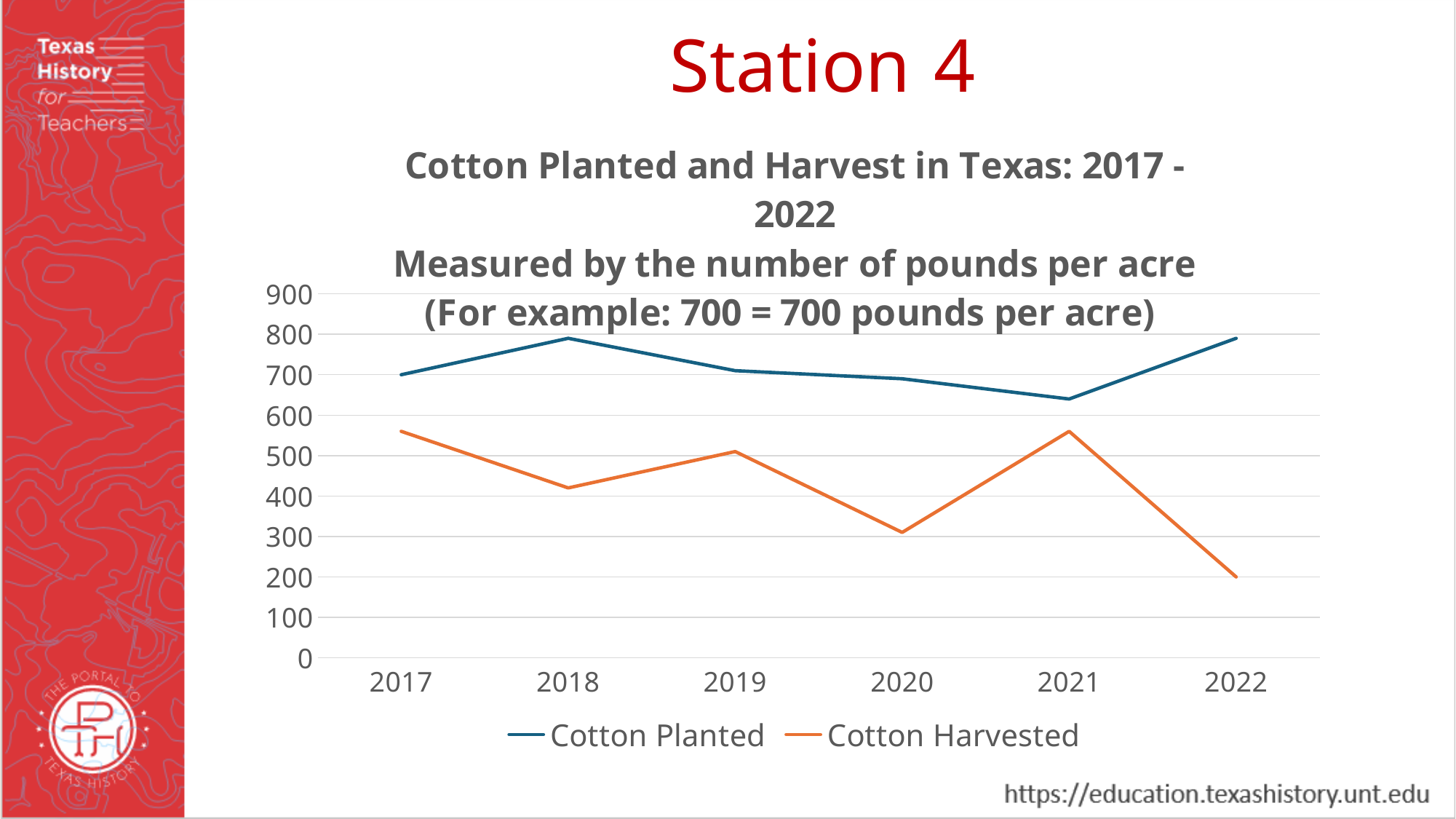
Is the value for Cotton Planted in 2018 greater or less than 700? greater How many years are plotted along the x axis? 6 What kind of chart is shown on the slide? Line chart What colour is the Cotton Harvested line? Orange What is the value for Cotton Planted in 2017? 700 What is the value for Cotton Harvested in 2022? 200 Which is larger in 2019, Cotton Planted or Cotton Harvested? Cotton Planted How many series does the legend list? 2 Does Cotton Harvested rise or fall from 2021 to 2022? Fall In which year is Cotton Planted lowest? 2021 Is the value for Cotton Harvested in 2020 greater or less than 400? less In which year is Cotton Harvested lowest? 2022